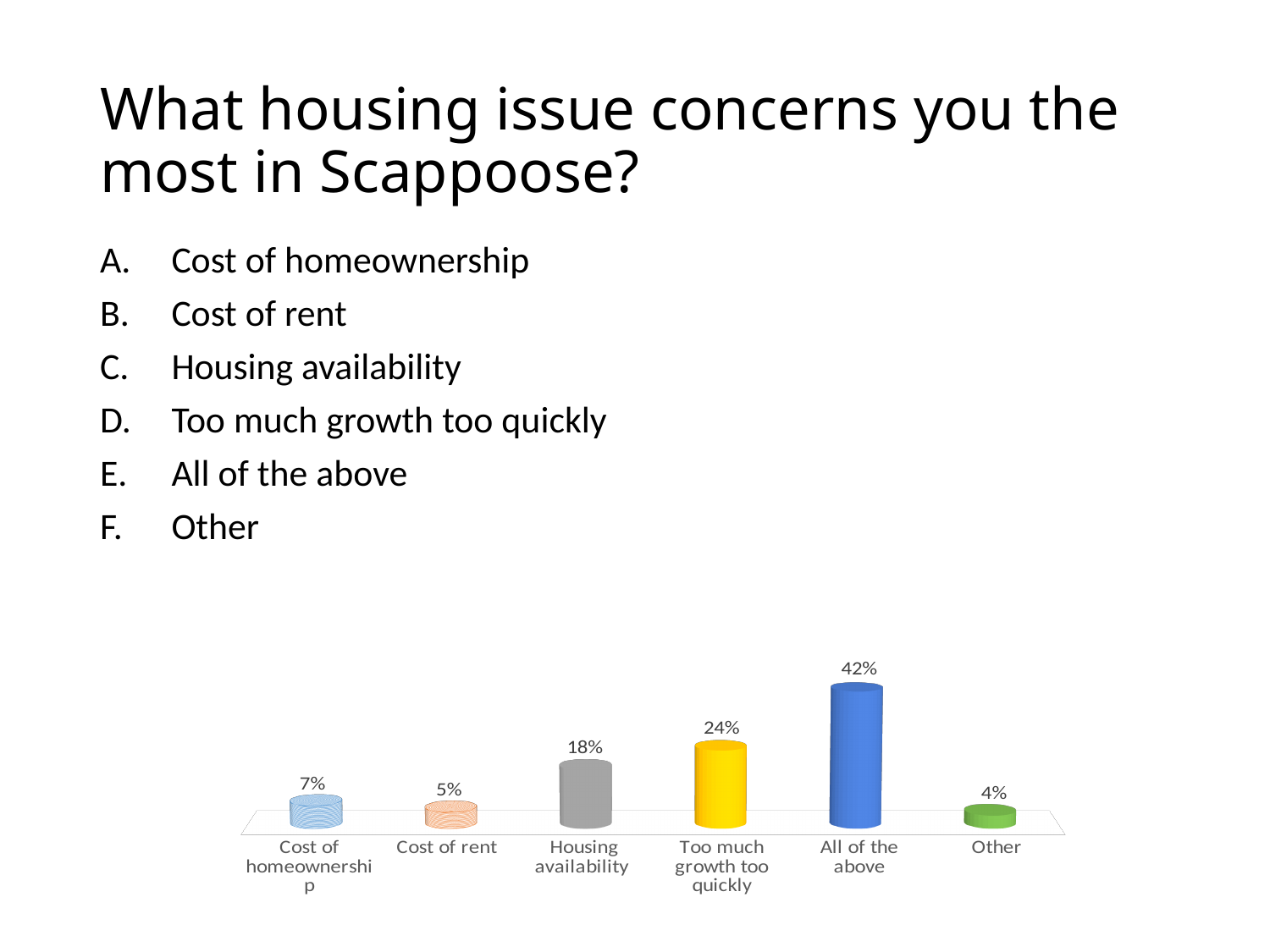
What colour is the bar for 'All of the above'? Blue What is the value shown for 'Cost of rent'? 5% What is the combined value of 'Cost of homeownership' and 'Cost of rent'? 12% What is the value shown for 'Housing availability'? 18% Which category has the highest value in the chart? All of the above What is the difference between the values for 'Cost of homeownership' and 'Cost of rent'? 2% Which is larger, the value for 'Housing availability' or the value for 'Too much growth too quickly'? Too much growth too quickly What is the difference between the values for 'All of the above' and 'Too much growth too quickly'? 18% How many categories are shown in the chart? 6 What kind of chart is shown on the slide? Bar chart What percentage of respondents chose 'All of the above' as their biggest housing concern? 42% Which category has the lowest value in the chart? Other